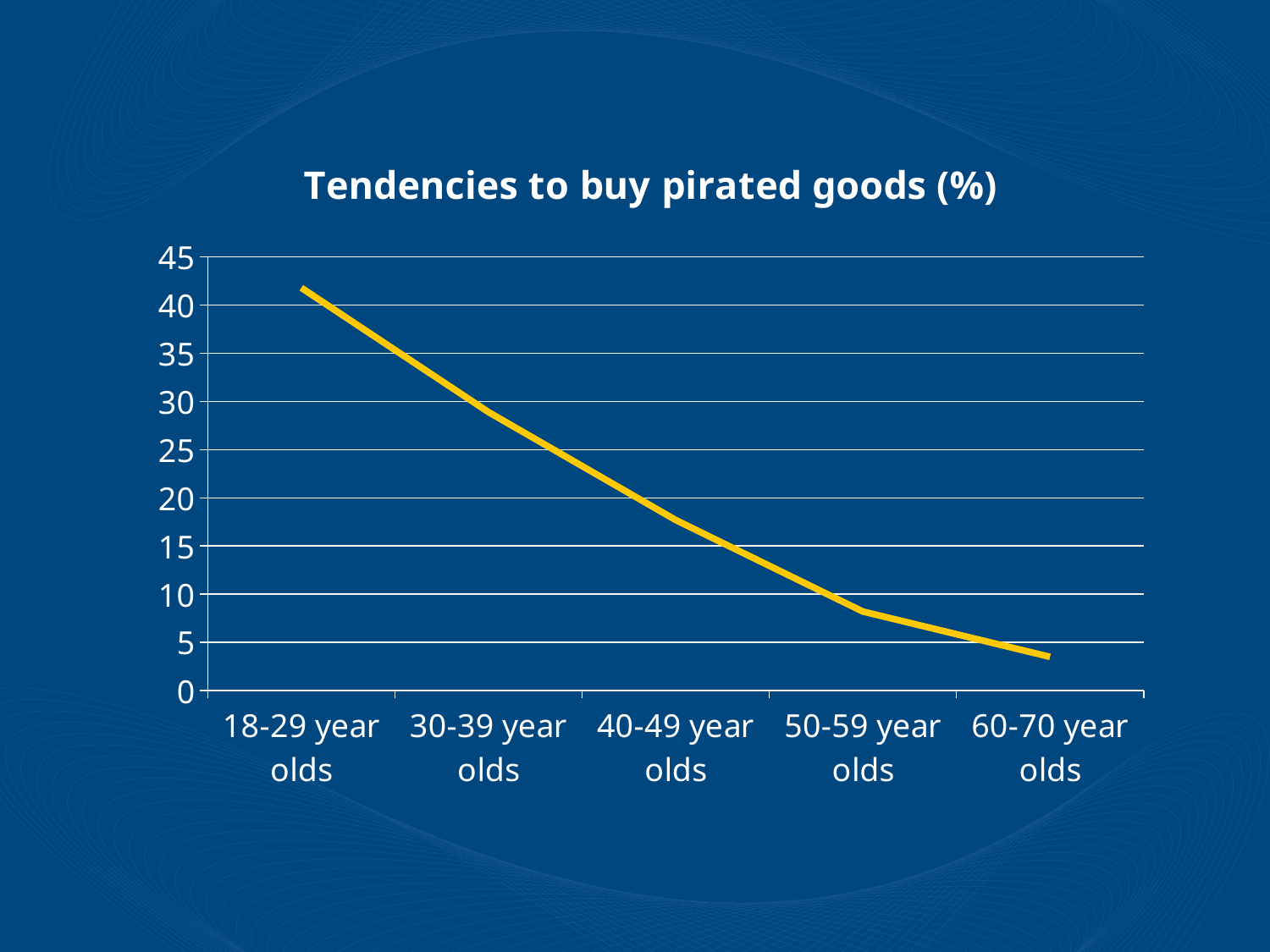
Is the value for 30-39 year olds greater or less than 35? less Which age group has the lowest tendency to buy pirated goods? 60-70 year olds Is the value for 60-70 year olds greater or less than 5? less Is the value for 40-49 year olds greater or less than 25? less What is the title of the chart? Tendencies to buy pirated goods (%) Which is larger, the value for 30-39 year olds or the value for 50-59 year olds? 30-39 year olds Do the values rise or fall as age increases along the x axis? fall How many age groups are plotted on the x axis? 5 What kind of chart is shown on the slide? line chart Which age group has the highest tendency to buy pirated goods? 18-29 year olds